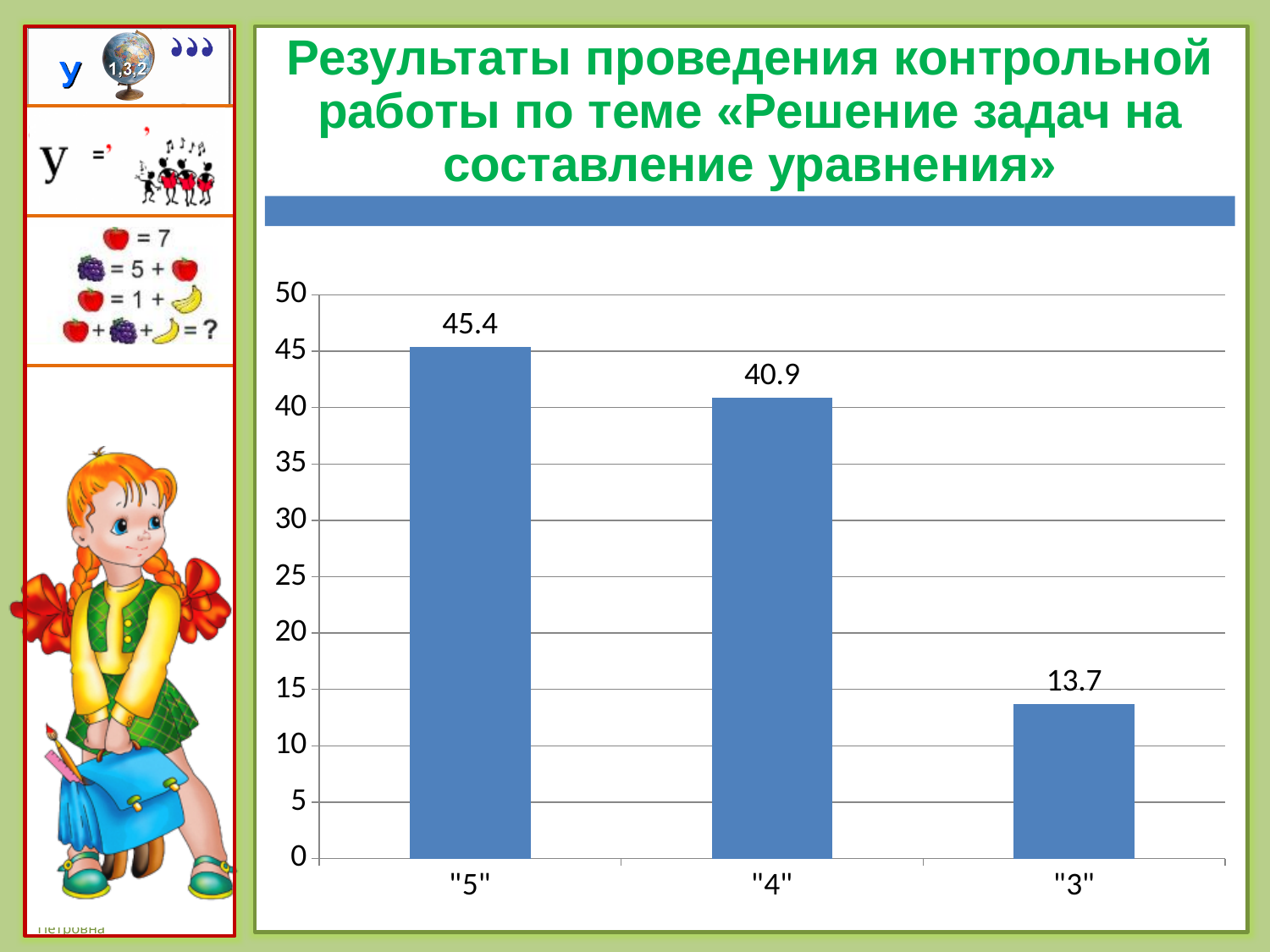
What is the difference between the values for "5" and "4"? 4.5 What is the value for the "5" category? 45.4 What kind of chart is shown on the slide? bar chart What is the difference between the values for "4" and "3"? 27.2 Which category has the highest value? "5" Which is larger, the value for "4" or the value for "3"? "4" Which category has the lowest value? "3" What is the value for the "4" category? 40.9 What is the value for the "3" category? 13.7 Do the values rise or fall from left to right along the x axis? fall How many categories are shown on the x axis? 3 Is the value for "3" greater or less than 15? less